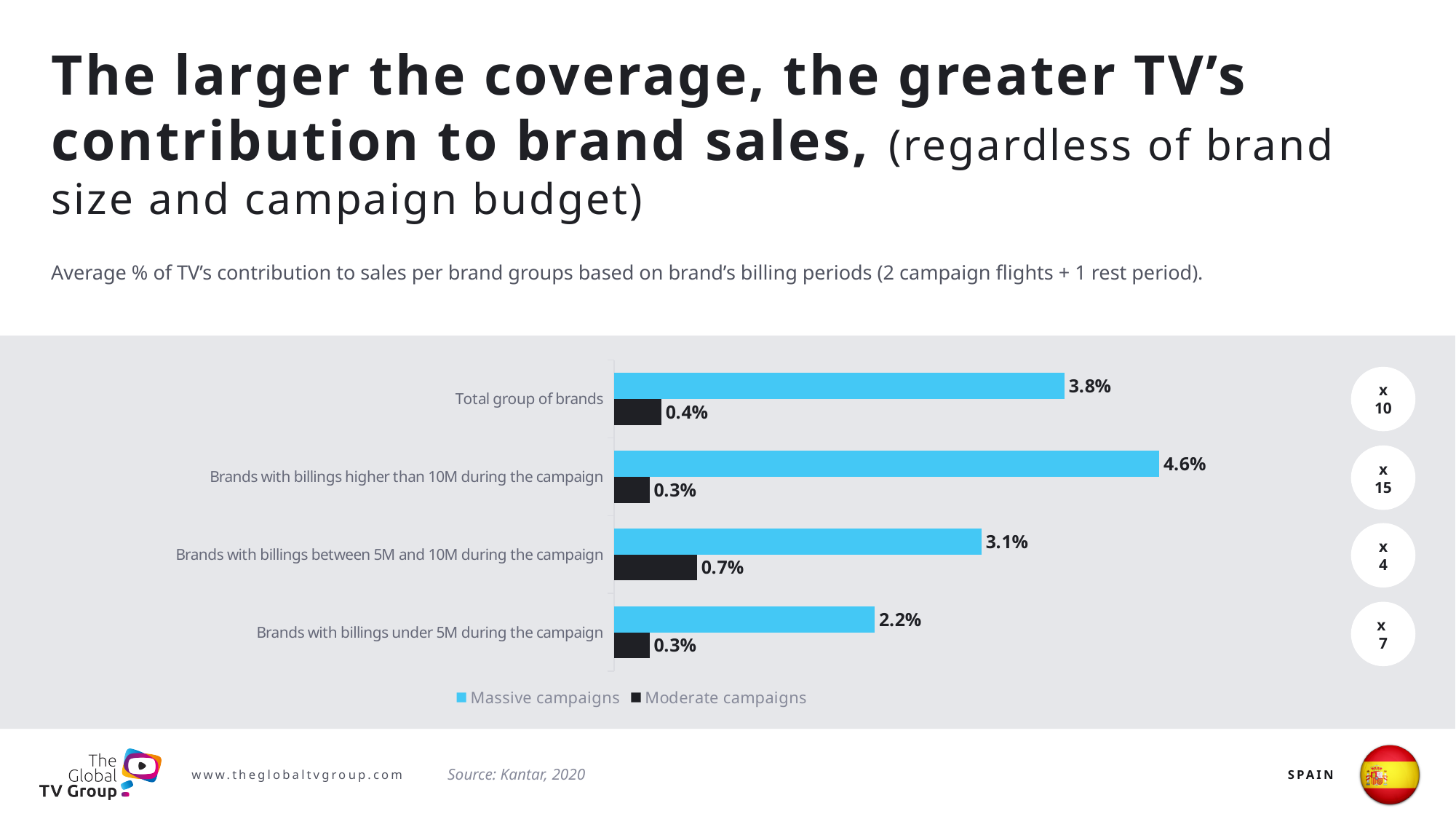
Which category has the lowest value for Massive campaigns? Brands with billings under 5M during the campaign What is the difference between the Massive campaigns values for the Total group of brands and Brands with billings between 5M and 10M during the campaign? 0.7% What is the difference between the Massive campaigns and Moderate campaigns values for Brands with billings higher than 10M during the campaign? 4.3% What is the value for Massive campaigns for the Total group of brands? 3.8% What kind of chart is shown on the slide? Bar chart What is the value for Moderate campaigns for Brands with billings between 5M and 10M during the campaign? 0.7% Which category has the highest value for Massive campaigns? Brands with billings higher than 10M during the campaign How many categories are shown on the chart? 4 Which colour represents Moderate campaigns in the chart? Black How many series does the legend list? 2 Which is larger: the Moderate campaigns value for Brands with billings between 5M and 10M or for Brands with billings under 5M? Brands with billings between 5M and 10M during the campaign What is the value for Massive campaigns for Brands with billings under 5M during the campaign? 2.2%